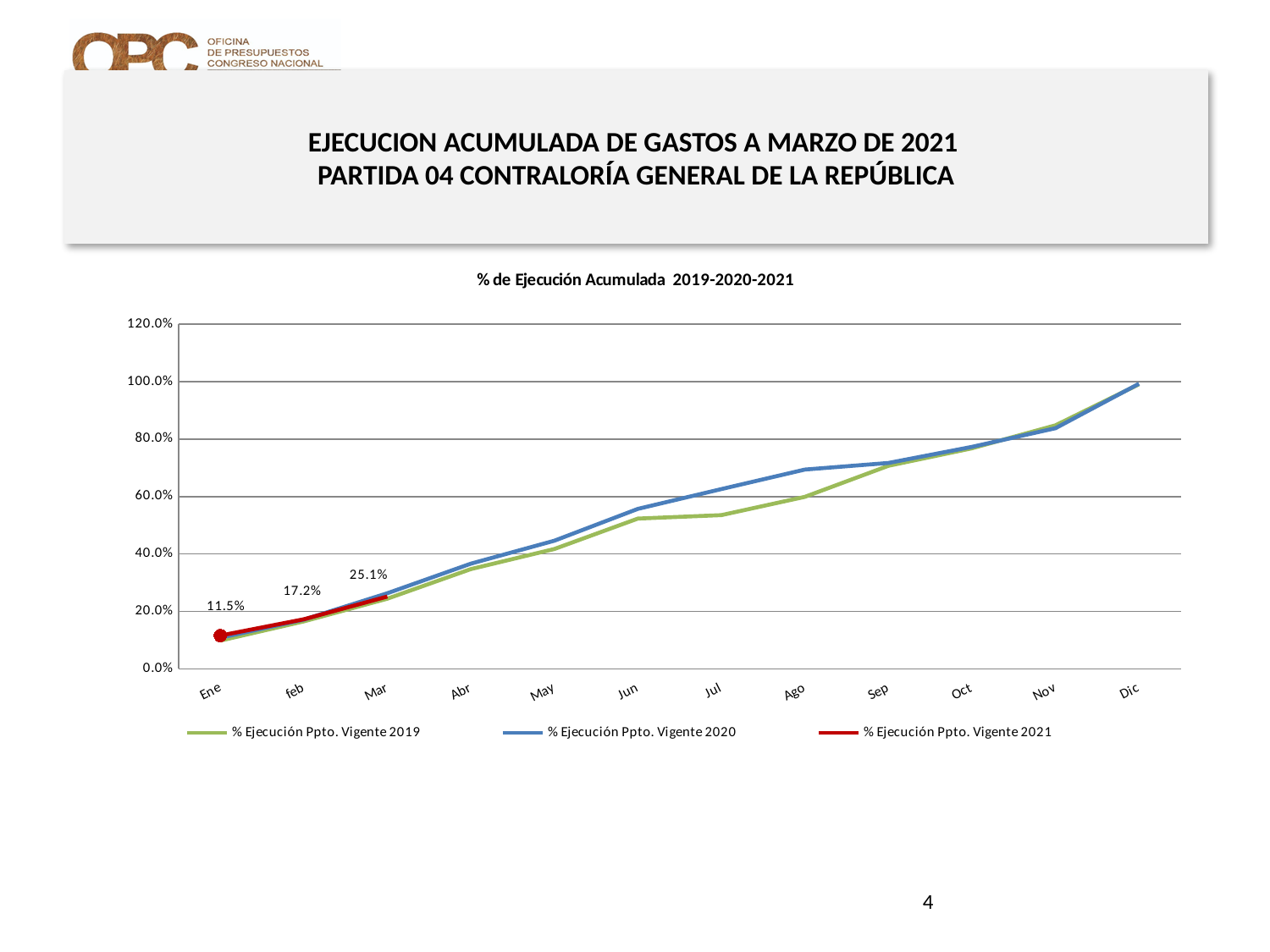
Do the values for % Ejecución Ppto. Vigente 2020 rise or fall from Ene to Dic? Rise What kind of chart is shown on the slide? Line chart How many series does the legend list? 3 Which month has the highest value for the % Ejecución Ppto. Vigente 2021 series? Mar What is the difference between the 2021 values for Mar and Feb? 7.9% What is the value of % Ejecución Ppto. Vigente 2021 for Ene? 11.5% Is the value for % Ejecución Ppto. Vigente 2020 in Ago greater or less than 60.0%? greater What is the value of % Ejecución Ppto. Vigente 2021 for Feb? 17.2% What is the value of % Ejecución Ppto. Vigente 2021 for Mar? 25.1% What is the difference between the 2021 values for Mar and Ene? 13.6% How many months are shown on the x axis? 12 In Ago, which series has the larger value, % Ejecución Ppto. Vigente 2019 or % Ejecución Ppto. Vigente 2020? % Ejecución Ppto. Vigente 2020